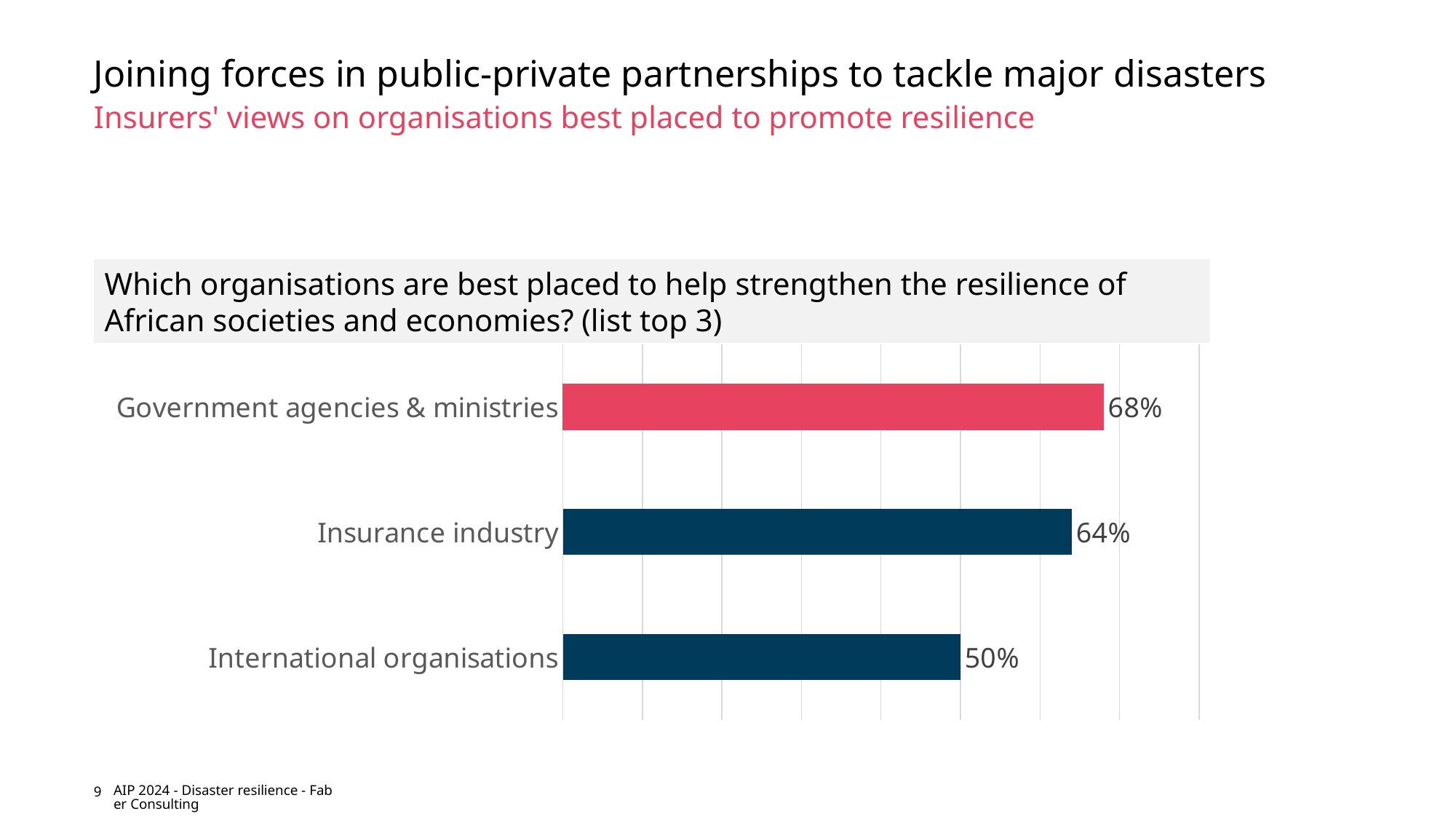
What is the value shown for International organisations? 50% What type of chart is used on this slide? Bar chart What question is the chart answering, as shown in the grey box above it? Which organisations are best placed to help strengthen the resilience of African societies and economies? (list top 3) Which organisation has the highest percentage in the chart? Government agencies & ministries Which has a higher value, Insurance industry or International organisations? Insurance industry Which bar is highlighted in a different colour (red/pink) from the others? Government agencies & ministries How many organisation categories are shown in the chart? 3 What is the difference in percentage points between Government agencies & ministries and Insurance industry? 4 percentage points What is the value shown for Insurance industry? 64% What is the difference in percentage points between Government agencies & ministries and International organisations? 18 percentage points Which organisation has the lowest percentage in the chart? International organisations What percentage of insurers named Government agencies & ministries as best placed to help strengthen resilience? 68%